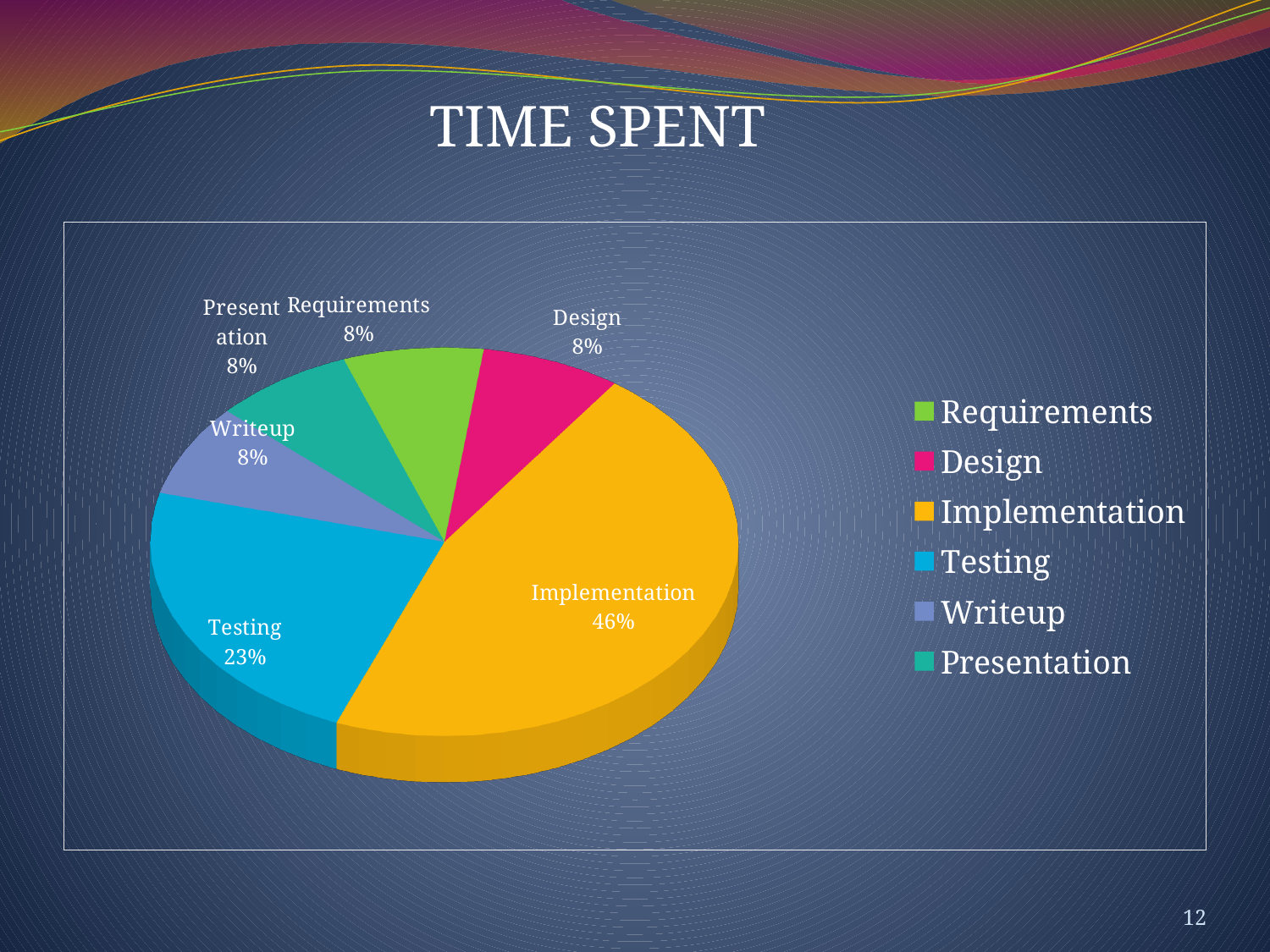
What share of time was spent on Implementation? 46% What share of time was spent on Writeup? 8% What share of time was spent on Design? 8% What is the title of the chart? TIME SPENT What kind of chart is shown on the slide? Pie chart What is the combined share of Requirements, Design, Writeup and Presentation? 32% Which colour represents Testing in the legend? Blue Which phase took the largest share of time? Implementation Which is larger, the share for Testing or the share for Requirements? Testing What is the difference in percentage points between the Implementation and Testing shares? 23 How many slices does the pie chart have? 6